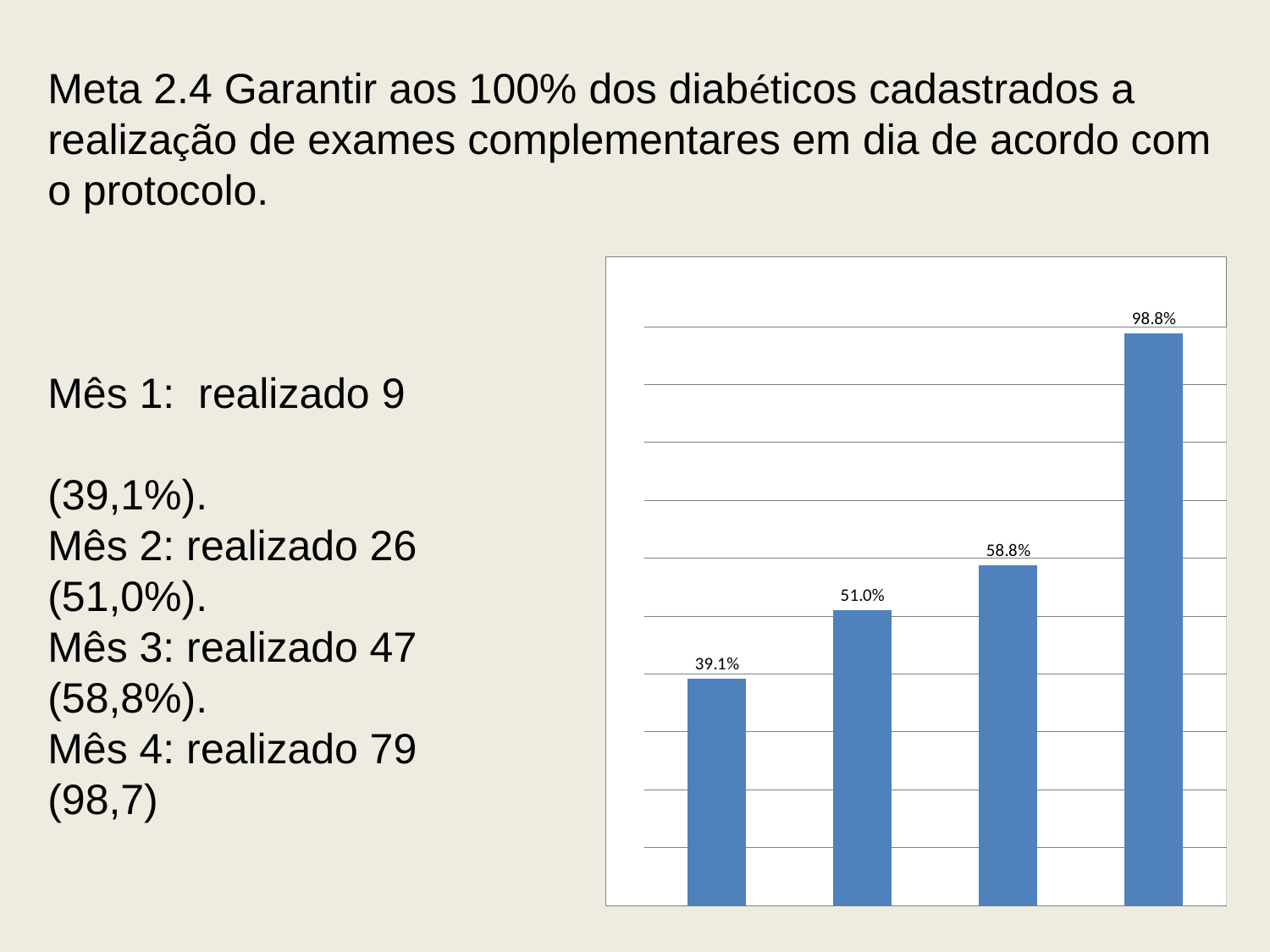
What is the difference between the fourth bar (98.8%) and the third bar (58.8%)? 40.0% What is the highest value shown in the chart? 98.8% Do the bar values rise or fall from left to right across the chart? rise What kind of chart is shown on the slide? bar chart How many bars does the chart show? 4 What is the value labelled on the first (leftmost) bar of the chart? 39.1% What is the value labelled on the fourth (rightmost) bar of the chart? 98.8% What is the value labelled on the second bar of the chart? 51.0% Which is larger, the value of the second bar or the value of the third bar? the third bar (58.8%) What is the difference between the second bar (51.0%) and the first bar (39.1%)? 11.9% What is the lowest value shown in the chart? 39.1% What is the value labelled on the third bar of the chart? 58.8%